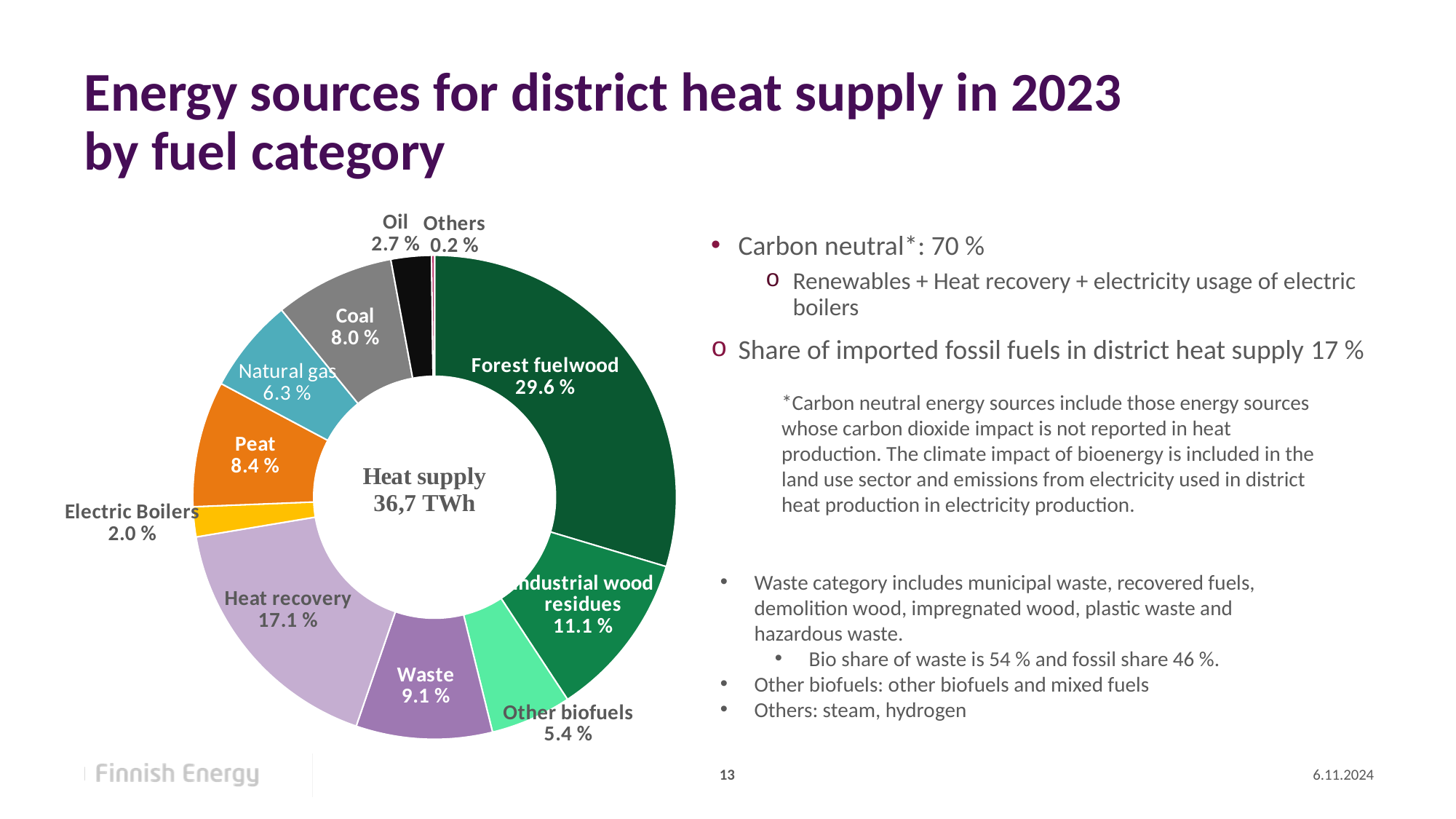
What kind of chart is used to show the energy sources? Pie (donut) chart What share of district heat supply comes from Natural gas? 6.3 % What share of district heat supply comes from Heat recovery? 17.1 % Which has a larger share, Waste or Coal? Waste How many fuel categories are shown in the chart? 11 Which fuel category has the smallest share of district heat supply? Others What total heat supply is shown in the centre of the chart? 36,7 TWh What share of district heat supply comes from Electric Boilers? 2.0 % What is the difference in share between Forest fuelwood and Industrial wood residues? 18.5 % What is the difference in share between Peat and Coal? 0.4 % What share of district heat supply comes from Forest fuelwood? 29.6 % Which fuel category has the largest share of district heat supply? Forest fuelwood